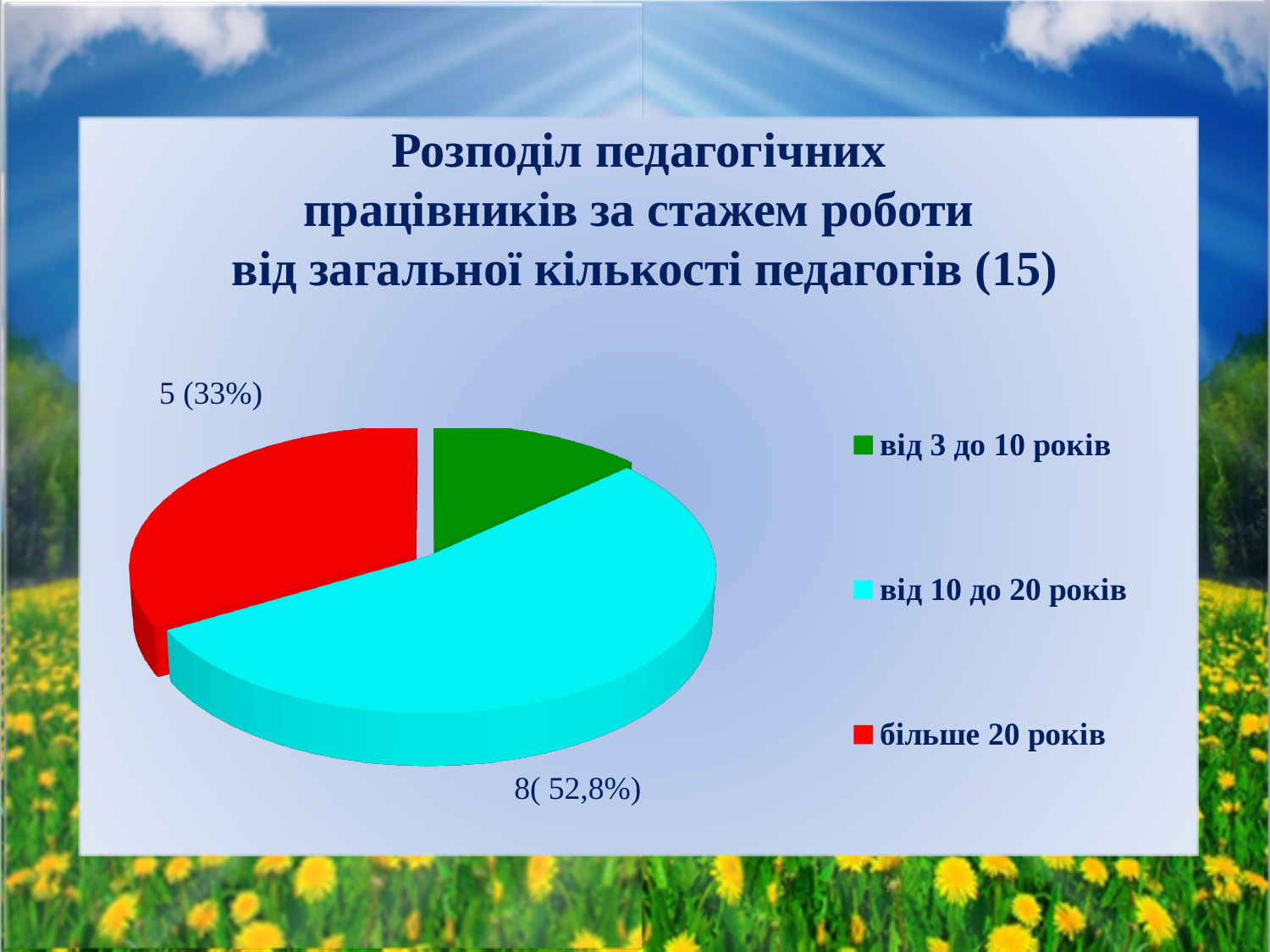
What is the difference in the number of teachers between "від 10 до 20 років" and "більше 20 років"? 3 How many teachers are in the "від 10 до 20 років" category? 8 How many entries does the legend list? 3 How many slices does the pie chart have? 3 Which category has the smallest slice of the pie? від 3 до 10 років What share of the pie does the "від 10 до 20 років" slice represent? 52,8% How many teachers are in the "більше 20 років" category? 5 What share of the pie does the "більше 20 років" slice represent? 33% What colour is the "більше 20 років" slice? red Which category is larger: "більше 20 років" or "від 3 до 10 років"? більше 20 років What kind of chart is shown on the slide? pie chart Which category has the largest slice of the pie? від 10 до 20 років